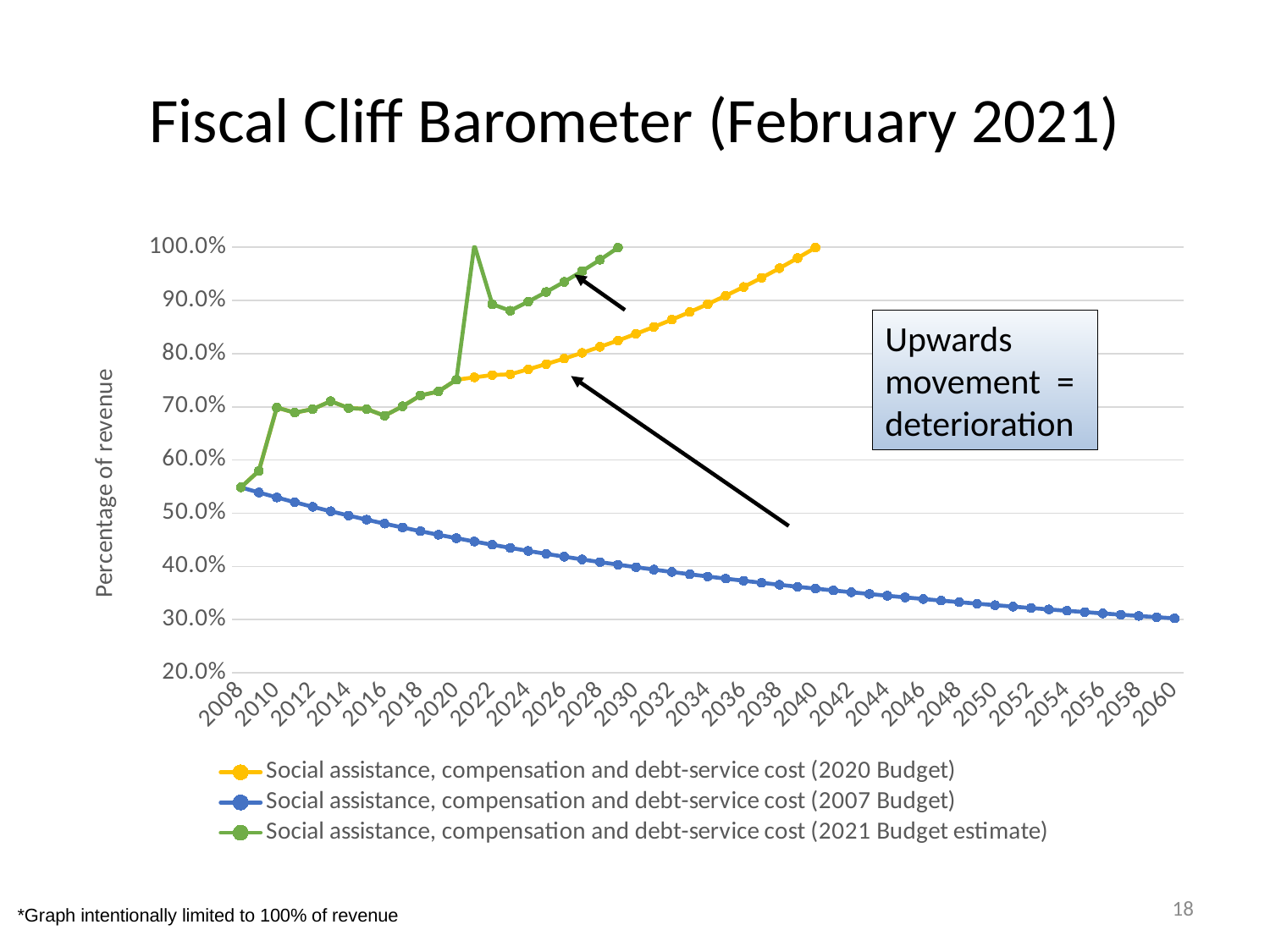
How many series does the legend list? 3 In 2026, which is higher: the 2021 Budget estimate series or the 2020 Budget series? 2021 Budget estimate Does the 'Social assistance, compensation and debt-service cost (2020 Budget)' series rise or fall from 2020 to 2040? Rise Is the value for the 2021 Budget estimate series in 2016 greater or less than 60.0%? greater Is the value for the 2007 Budget series in 2060 greater or less than 40.0%? less In 2030, which is higher: the 2020 Budget series or the 2007 Budget series? 2020 Budget What kind of chart is shown on the slide? Line chart Is the value for the 2020 Budget series in 2024 greater or less than 70.0%? greater What colour is the line for the 2021 Budget estimate series? Green Which series has the lowest value in 2020? Social assistance, compensation and debt-service cost (2007 Budget) Does the 'Social assistance, compensation and debt-service cost (2007 Budget)' series rise or fall from 2008 to 2060? Fall What is the title of the vertical axis? Percentage of revenue